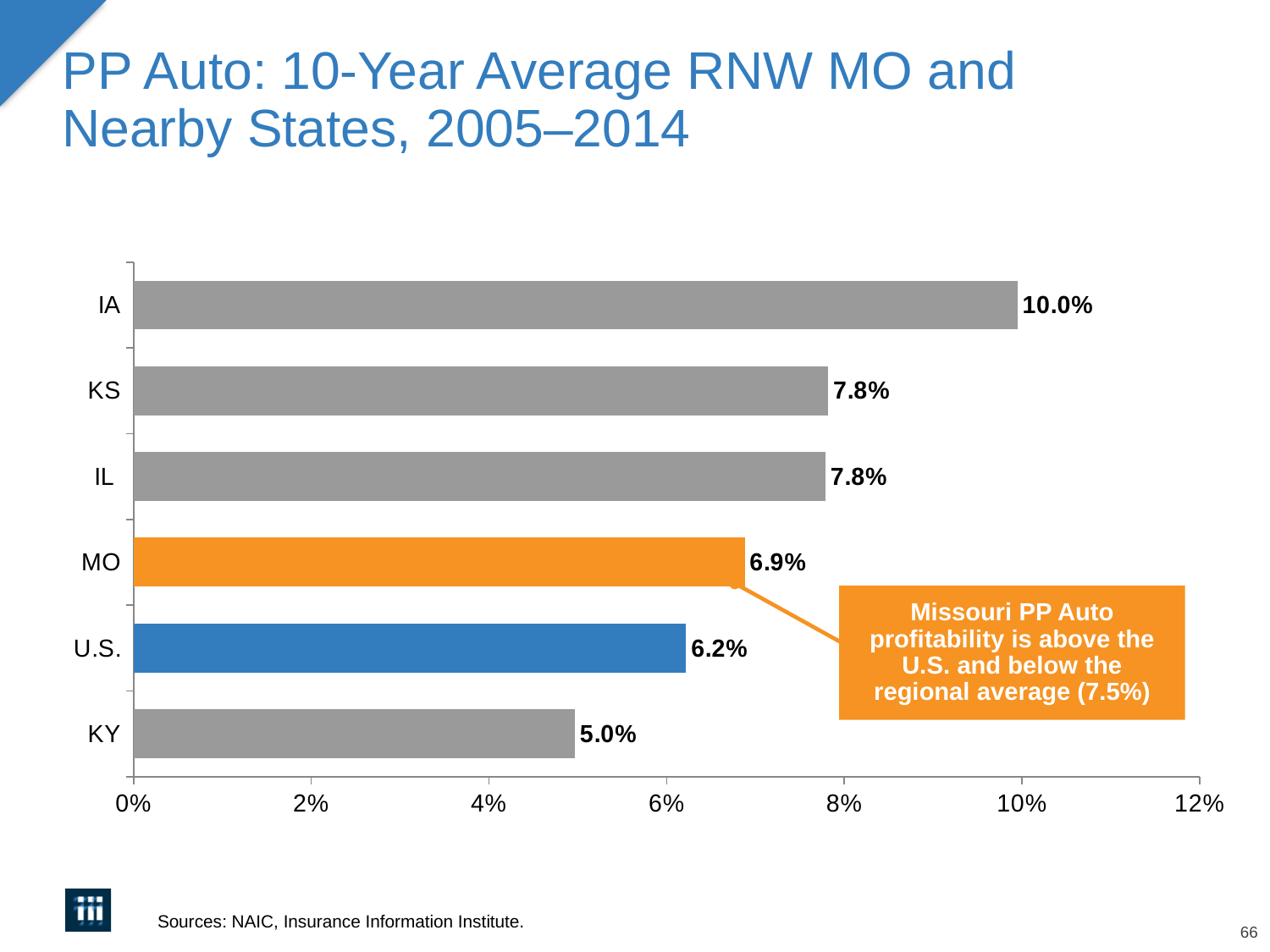
What kind of chart is shown on the slide? Bar chart What is the value shown for KY? 5.0% Which state has the highest 10-year average RNW? IA Is the value for IA greater or less than 8%? greater Which is larger, the value for KS or the value for MO? KS What regional average is stated in the callout box? 7.5% Which category has the lowest value on the chart? KY What is the difference between the MO value and the U.S. value? 0.7% What is the 10-year average RNW for MO? 6.9% What is the difference between the IA value and the MO value? 3.1% How many categories are shown on the chart? 6 What is the 10-year average RNW for the U.S.? 6.2%